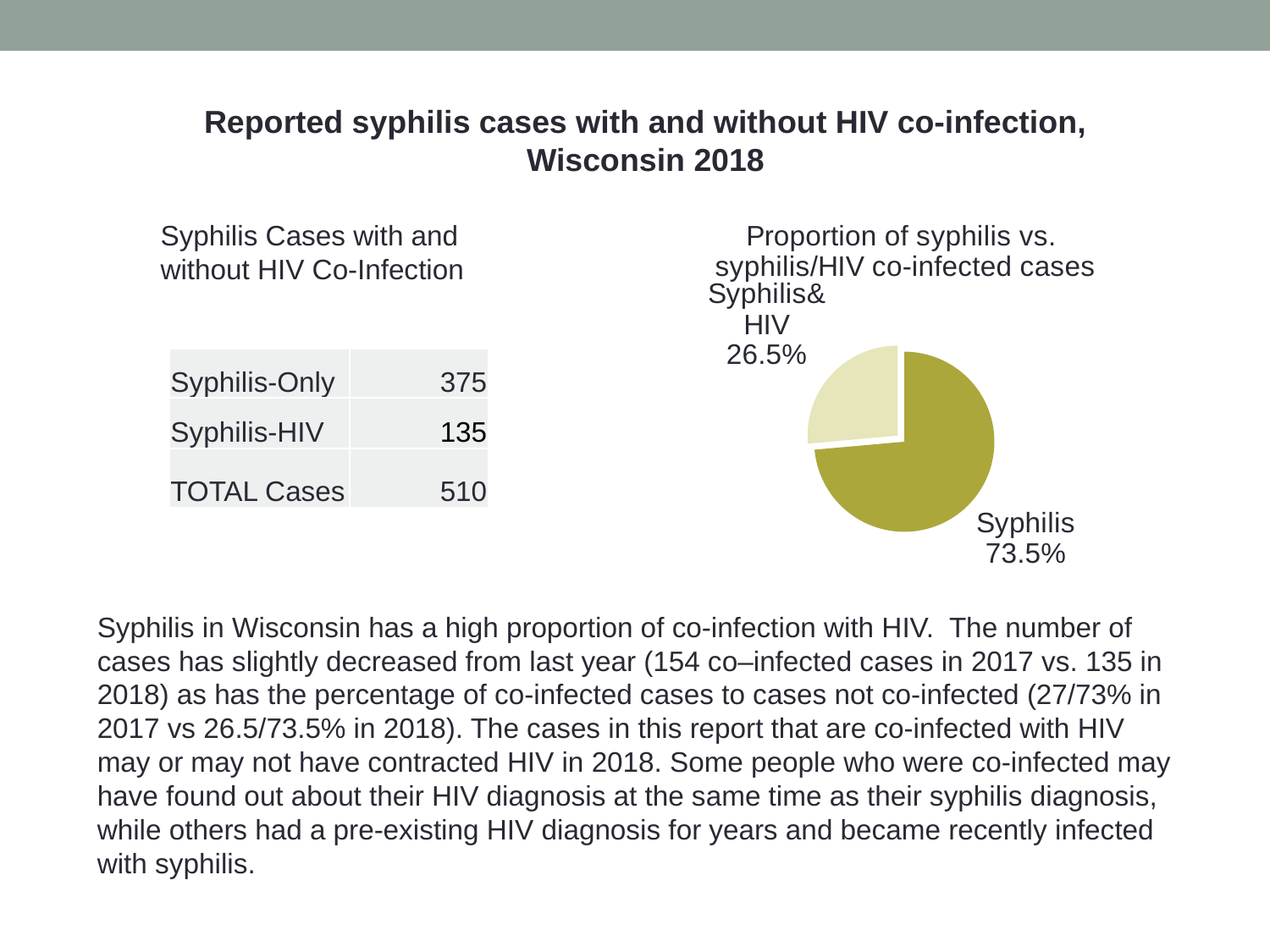
Is the Syphilis&HIV slice of the pie chart greater or less than 50%? less What share of the pie chart is labelled Syphilis&HIV? 26.5% What share of the pie chart is labelled Syphilis? 73.5% How many slices does the pie chart have? 2 What is the difference in percentage points between the Syphilis slice and the Syphilis&HIV slice in the pie chart? 47 percentage points In the pie chart, which is larger: the Syphilis slice or the Syphilis&HIV slice? Syphilis What kind of chart is shown on the slide? pie chart Is the Syphilis slice of the pie chart greater or less than 70%? greater What is the title of the pie chart? Proportion of syphilis vs. syphilis/HIV co-infected cases In the pie chart, which slice is shown in the darker olive colour? Syphilis Which slice of the pie chart is the smallest? Syphilis&HIV Which slice of the pie chart is the largest? Syphilis